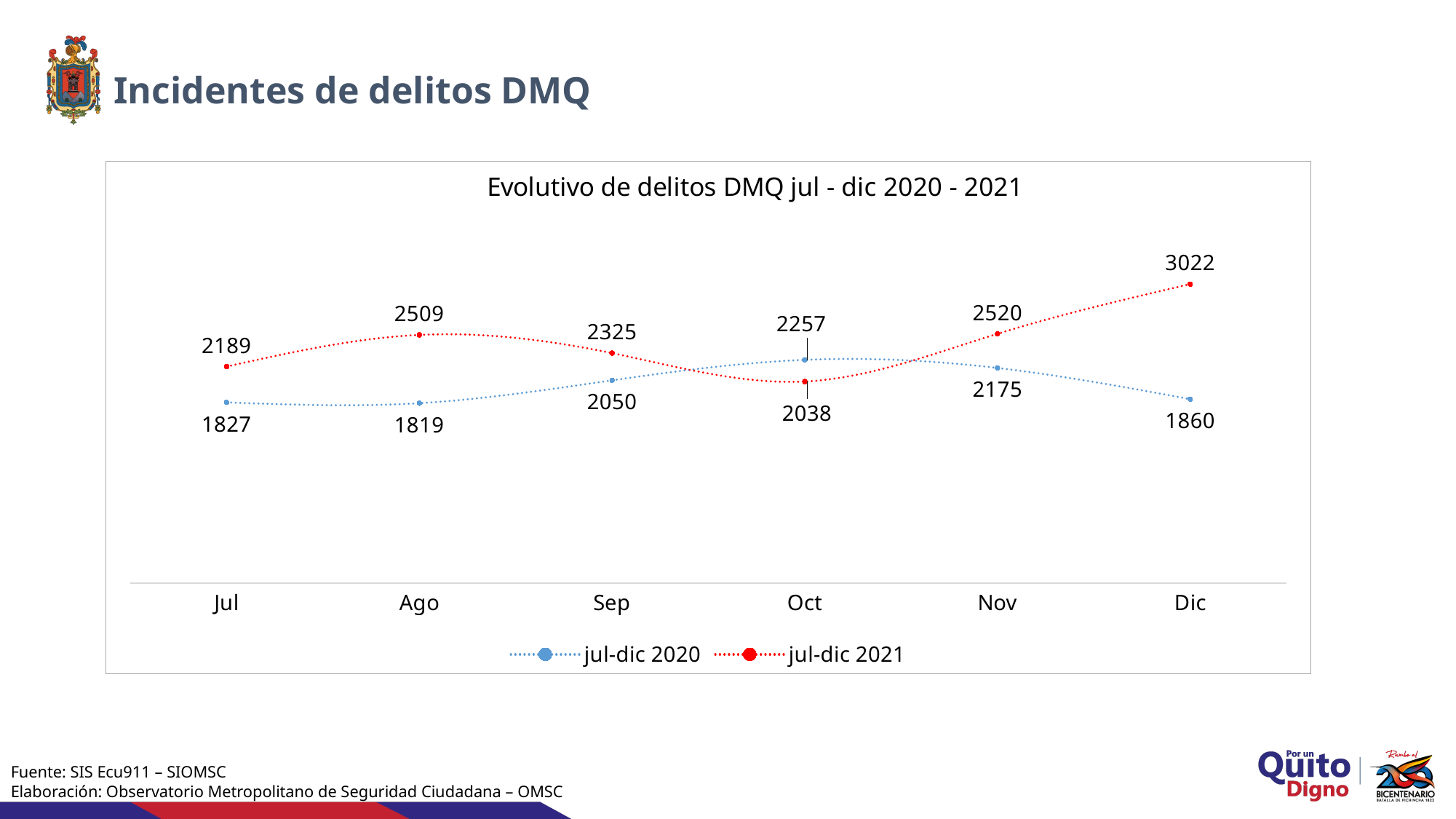
What is the difference between the jul-dic 2021 and jul-dic 2020 values in Dic? 1162 In which month is the jul-dic 2020 series highest? Oct Which series has the larger value in Oct, jul-dic 2020 or jul-dic 2021? jul-dic 2020 What is the value for jul-dic 2020 in Oct? 2257 What kind of chart is shown on the slide? line chart How many months are shown on the x axis? 6 What is the value for jul-dic 2021 in Dic? 3022 What is the title of the chart? Evolutivo de delitos DMQ jul - dic 2020 - 2021 What is the value for jul-dic 2021 in Ago? 2509 In which month is the jul-dic 2021 series lowest? Oct How many series does the legend list? 2 In which month is the jul-dic 2020 series lowest? Ago